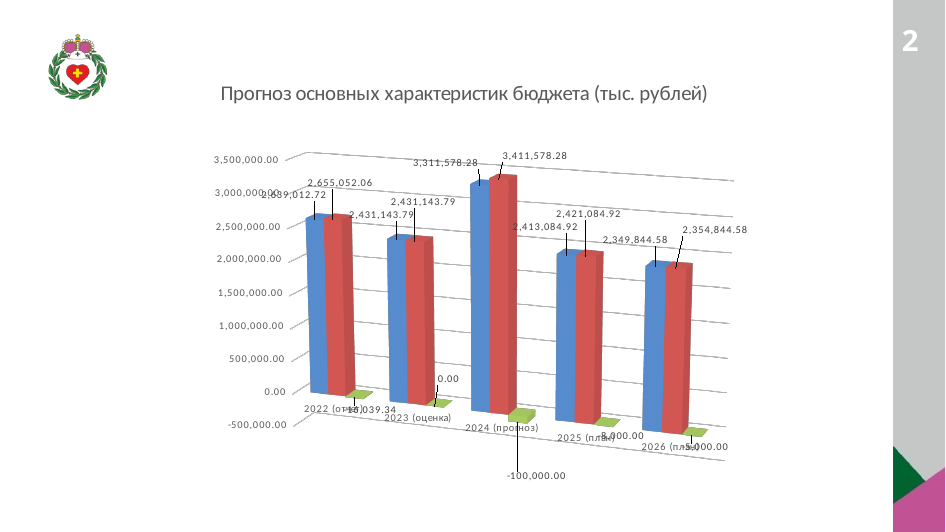
Which is larger: the red bar for 2025 (план) or the red bar for 2026 (план)? 2025 (план) What is the value of the blue bar for 2023 (оценка)? 2,431,143.79 What is the title of the chart? Прогноз основных характеристик бюджета (тыс. рублей) What is the value of the red bar for 2022 (отчет)? 2,655,052.06 What is the value of the blue bar for 2024 (прогноз)? 3,311,578.28 In which year is the red bar the lowest? 2026 (план) In which year is the red bar the highest? 2024 (прогноз) What is the value of the red bar for 2024 (прогноз)? 3,411,578.28 What kind of chart is shown on the slide? bar chart How many year categories are shown on the x axis? 5 What is the value of the green bar for 2024 (прогноз)? -100,000.00 What is the difference between the red and blue bars for 2024 (прогноз)? 100,000.00